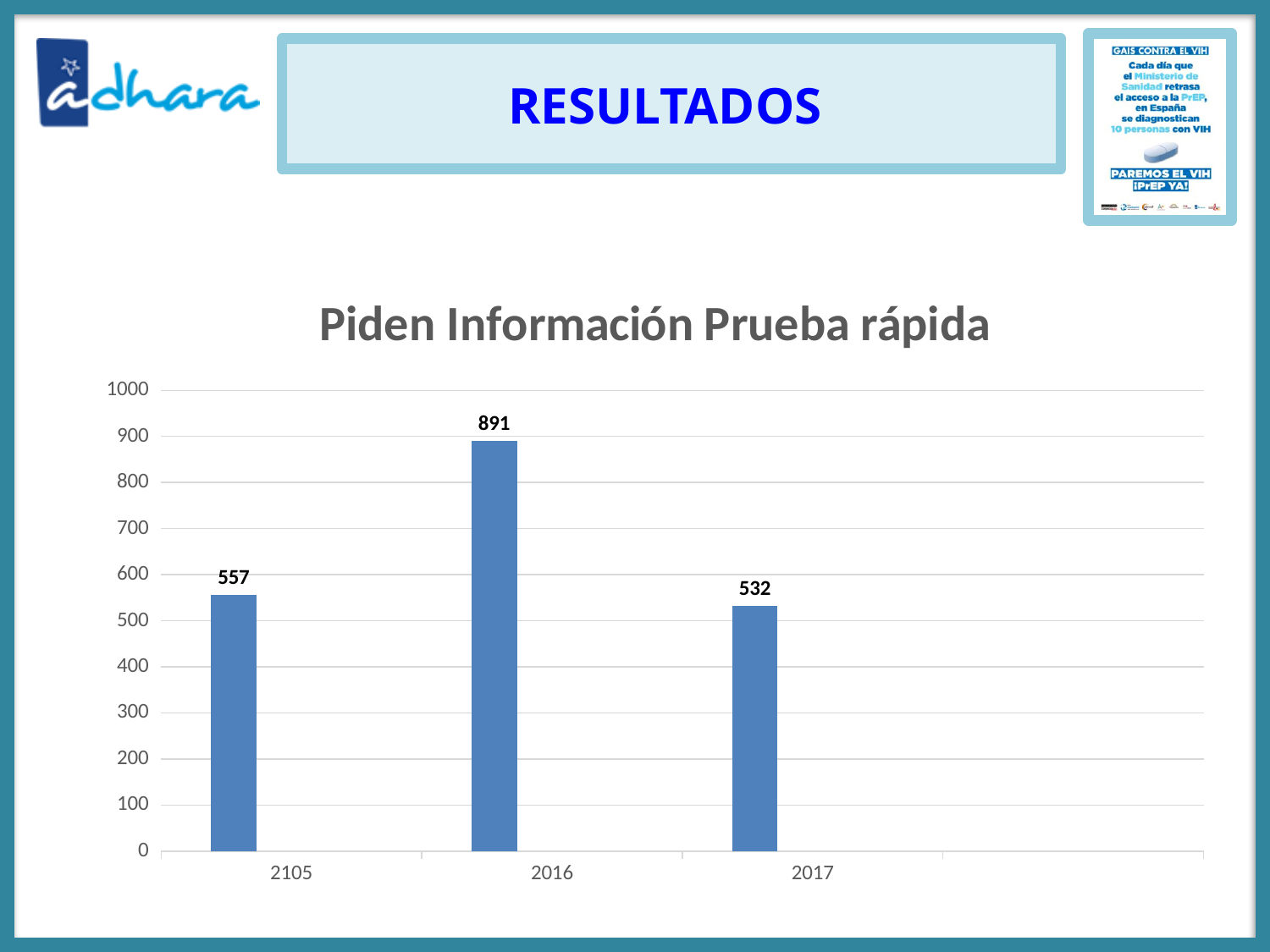
Which category has the highest value? 2016 What is the value for 2016 in the chart? 891 How many bars are shown in the chart? 3 Which is larger, the value for 2016 or the value for 2105? 2016 What is the difference between the values for 2016 and 2017? 359 Which category has the lowest value? 2017 What is the value for 2017? 532 Is the value for 2017 greater or less than 600? less What is the title of the chart? Piden Información Prueba rápida What is the value for the category labelled 2105? 557 What is the difference between the values for 2105 and 2017? 25 What kind of chart is shown on the slide? bar chart